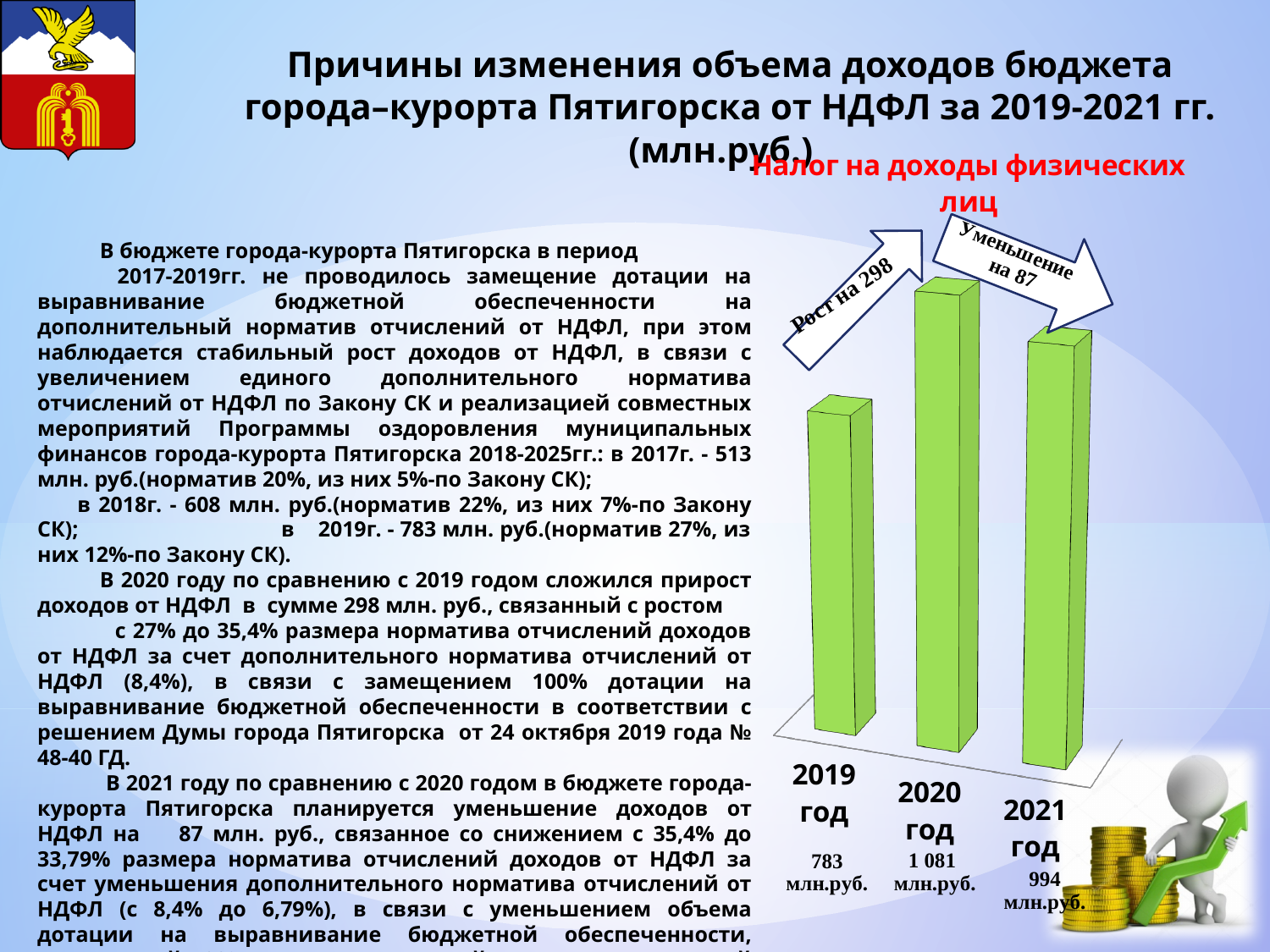
What is the title of the chart? Налог на доходы физических лиц What does the arrow between the 2019 and 2020 bars say? Рост на 298 What kind of chart is shown on the slide? Bar chart What is the value shown for 2021 год on the chart? 994 млн.руб. How many bars are shown on the chart? 3 What is the value shown for 2020 год on the chart? 1 081 млн.руб. Which is larger, the value for 2021 год or the value for 2019 год? 2021 год What is the difference between the values for 2020 год and 2019 год? 298 Which year has the highest value on the chart? 2020 год What is the difference between the values for 2020 год and 2021 год? 87 Which year has the lowest value on the chart? 2019 год What is the value shown for 2019 год on the chart? 783 млн.руб.